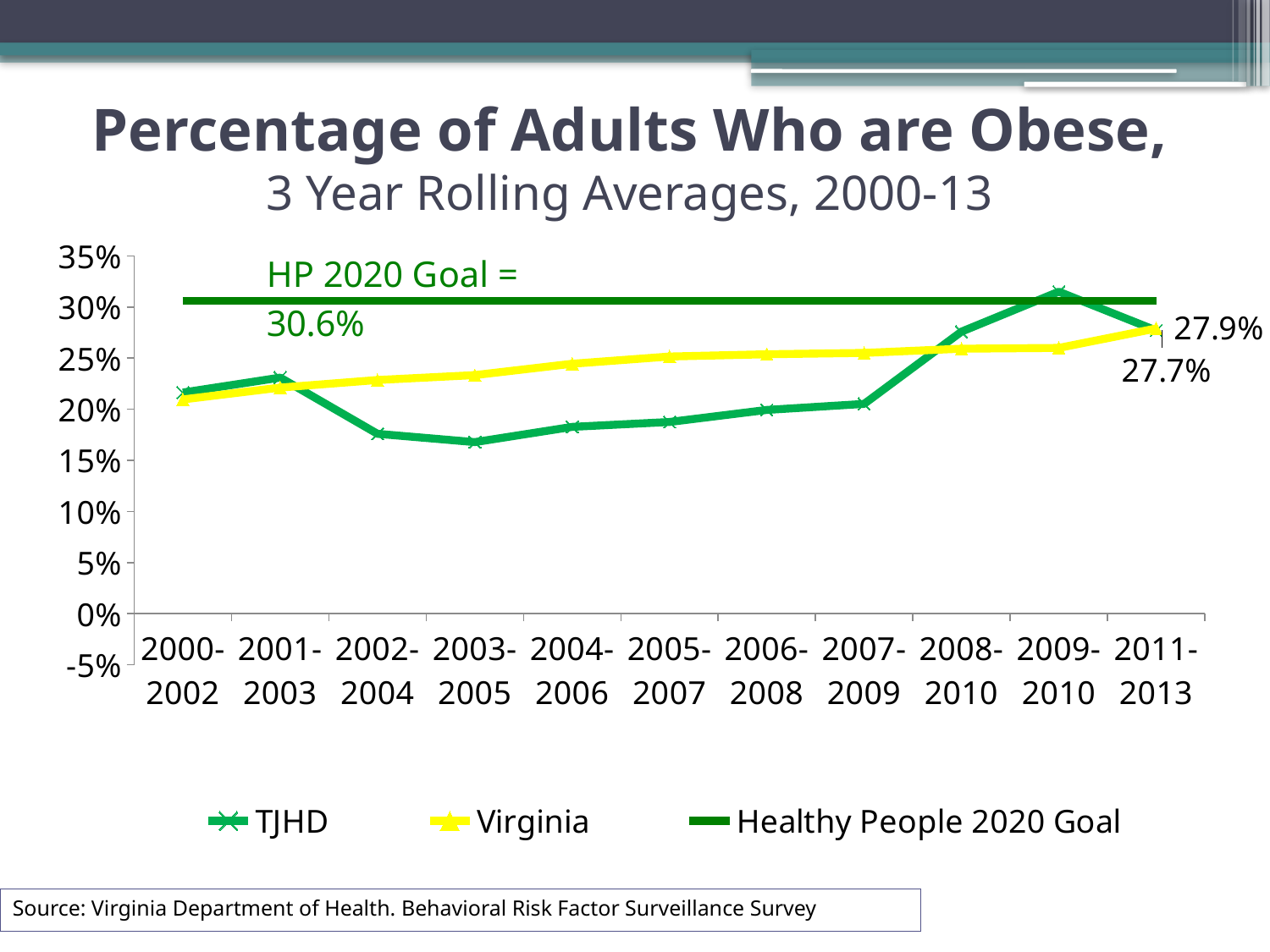
In which period is the TJHD value highest? 2009-2010 How many series does the legend list? 3 Which is larger in 2009-2010, the TJHD value or the Virginia value? TJHD What is the value of the HP 2020 Goal shown on the chart? 30.6% Is the TJHD value for 2003-2005 greater or less than 20%? less How many time periods are shown along the x axis? 11 Is the Virginia value for 2002-2004 greater or less than 20%? greater Which is larger in 2003-2005, the TJHD value or the Virginia value? Virginia What kind of chart is shown on the slide? line chart Does the Virginia series generally rise or fall from 2000-2002 to 2011-2013? rise Is the TJHD value for 2009-2010 greater or less than 30%? greater What are the three entries listed in the legend? TJHD, Virginia, Healthy People 2020 Goal